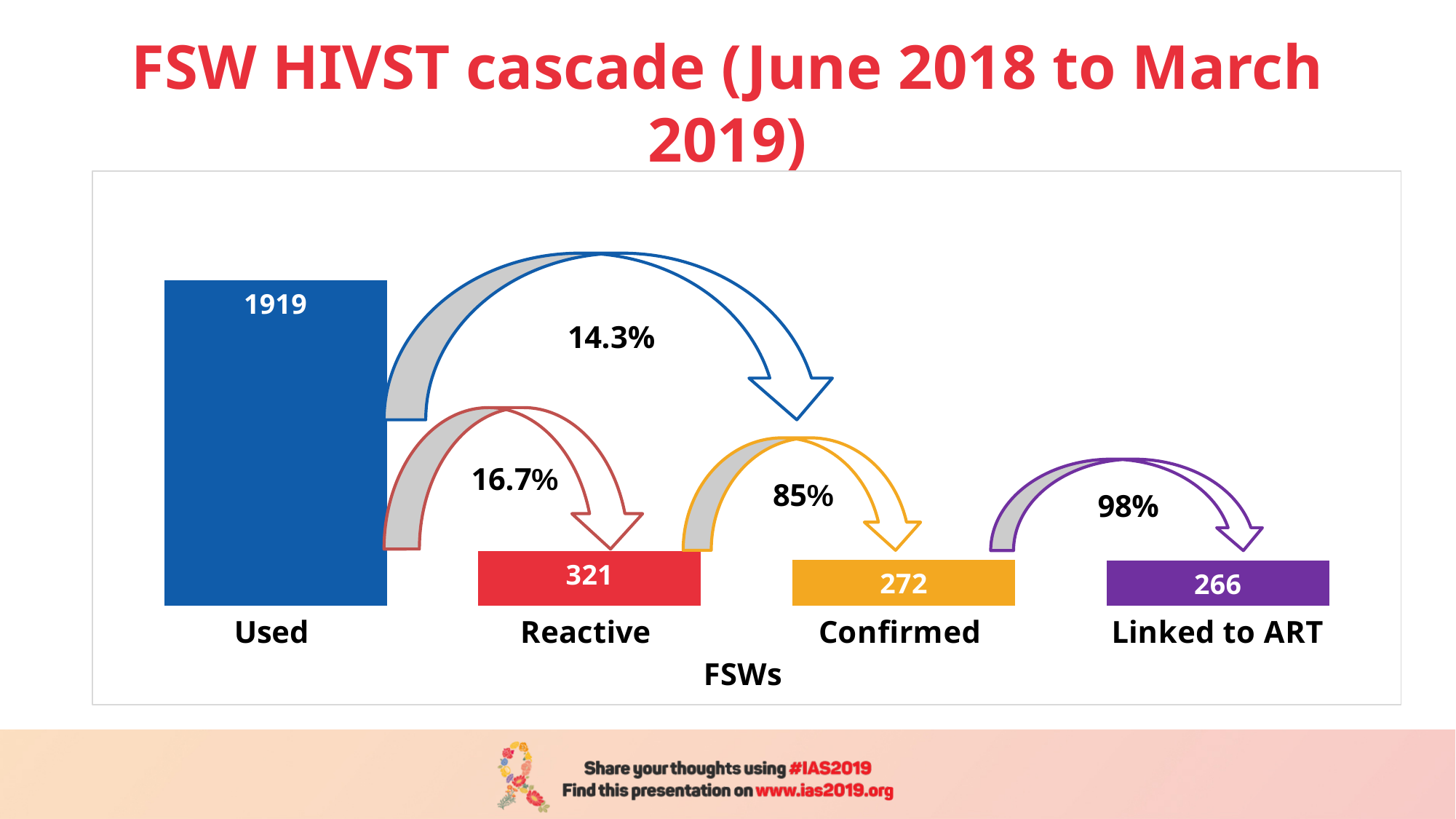
What is the difference between the values for Confirmed and Linked to ART? 6 Which category has the highest value? Used Do the values rise or fall from left to right along the x axis? fall What is the value for Used? 1919 Which is larger, the value for Reactive or the value for Confirmed? Reactive What is the value for Confirmed? 272 What is the value for Reactive? 321 What is the difference between the values for Used and Reactive? 1598 How many categories are shown on the x axis? 4 What is the value for Linked to ART? 266 Which category has the lowest value? Linked to ART What kind of chart is this? bar chart